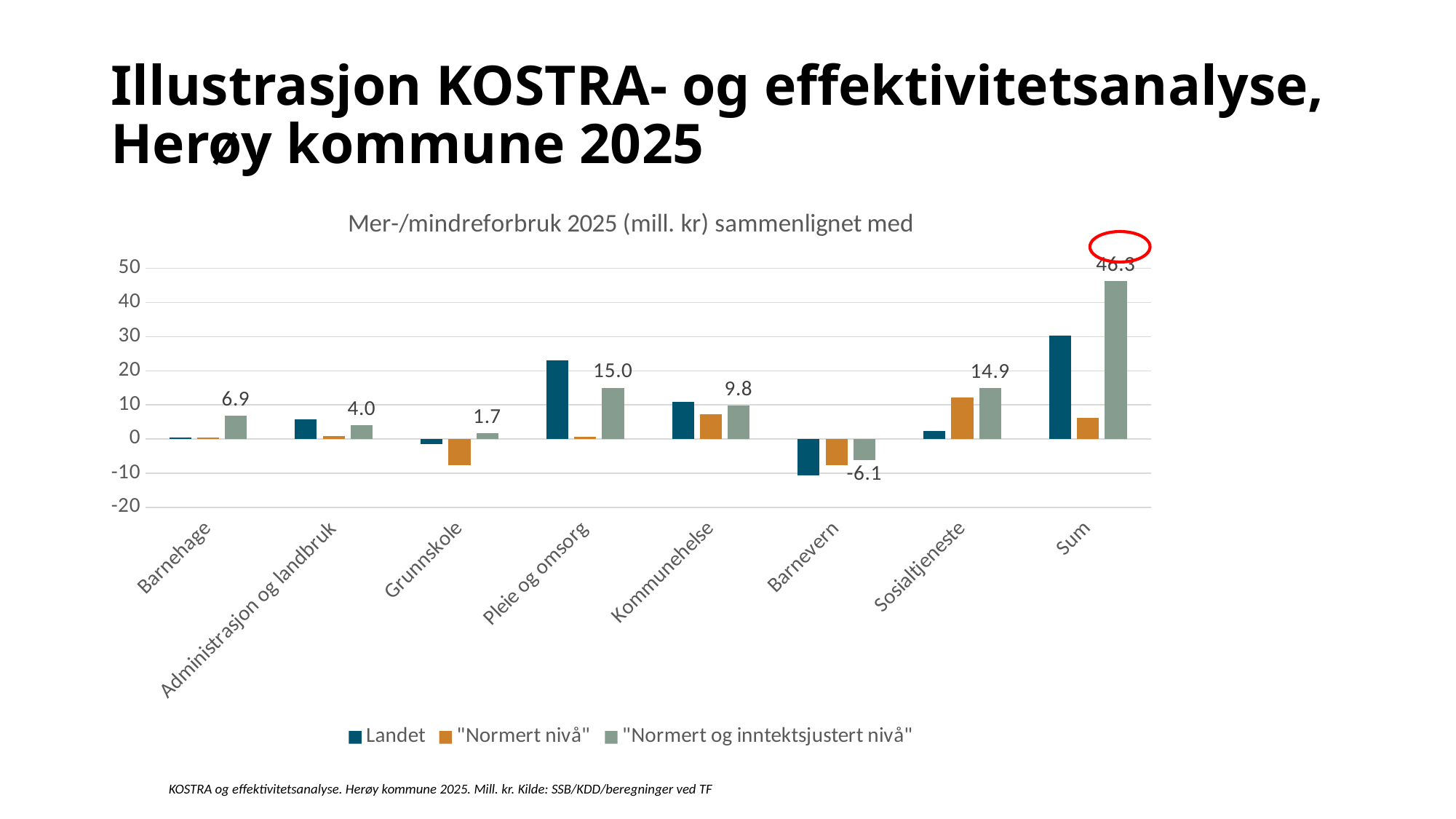
What is the difference between the "Normert og inntektsjustert nivå" values for Pleie og omsorg and Kommunehelse? 5.2 What is the value for Pleie og omsorg in the "Normert og inntektsjustert nivå" series? 15.0 How many series does the legend list? 3 Is the Landet value for Pleie og omsorg greater or less than 20? greater What kind of chart is shown on the slide? bar chart How many categories are shown on the x axis? 8 Which category has the highest value in the "Normert og inntektsjustert nivå" series? Sum What is the value for Sum in the "Normert og inntektsjustert nivå" series? 46.3 Which category has the lowest value in the "Normert og inntektsjustert nivå" series? Barnevern What is the value for Barnevern in the "Normert og inntektsjustert nivå" series? -6.1 What is the value for Barnehage in the "Normert og inntektsjustert nivå" series? 6.9 In the "Normert og inntektsjustert nivå" series, which is larger: Barnehage or Administrasjon og landbruk? Barnehage